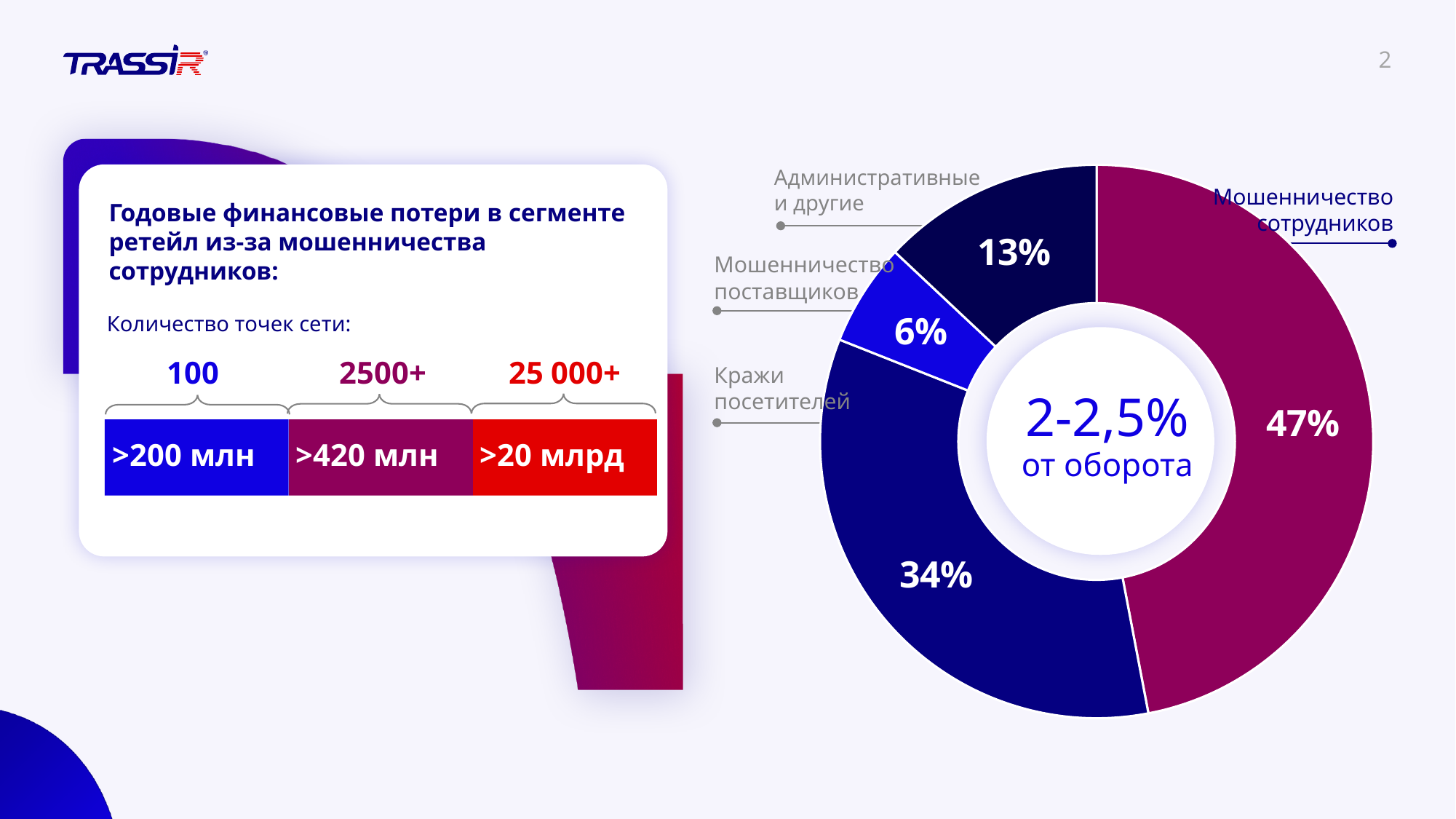
What kind of chart is shown on the right side of the slide? Donut (pie) chart In the donut chart, what share is labelled for "Мошенничество поставщиков"? 6% How many slices does the donut chart have? 4 In the donut chart, which is larger: "Административные и другие" or "Мошенничество поставщиков"? Административные и другие Which category has the largest slice in the donut chart? Мошенничество сотрудников In the donut chart, what share is labelled for "Кражи посетителей"? 34% In the donut chart, what is the combined share of "Мошенничество поставщиков" and "Административные и другие"? 19% In the donut chart, what is the difference in percentage points between "Мошенничество сотрудников" and "Кражи посетителей"? 13 In the donut chart, what share is labelled for "Административные и другие"? 13% Which category has the smallest slice in the donut chart? Мошенничество поставщиков What text is shown in the centre of the donut chart? 2-2,5% от оборота In the donut chart, what share is labelled for "Мошенничество сотрудников"? 47%